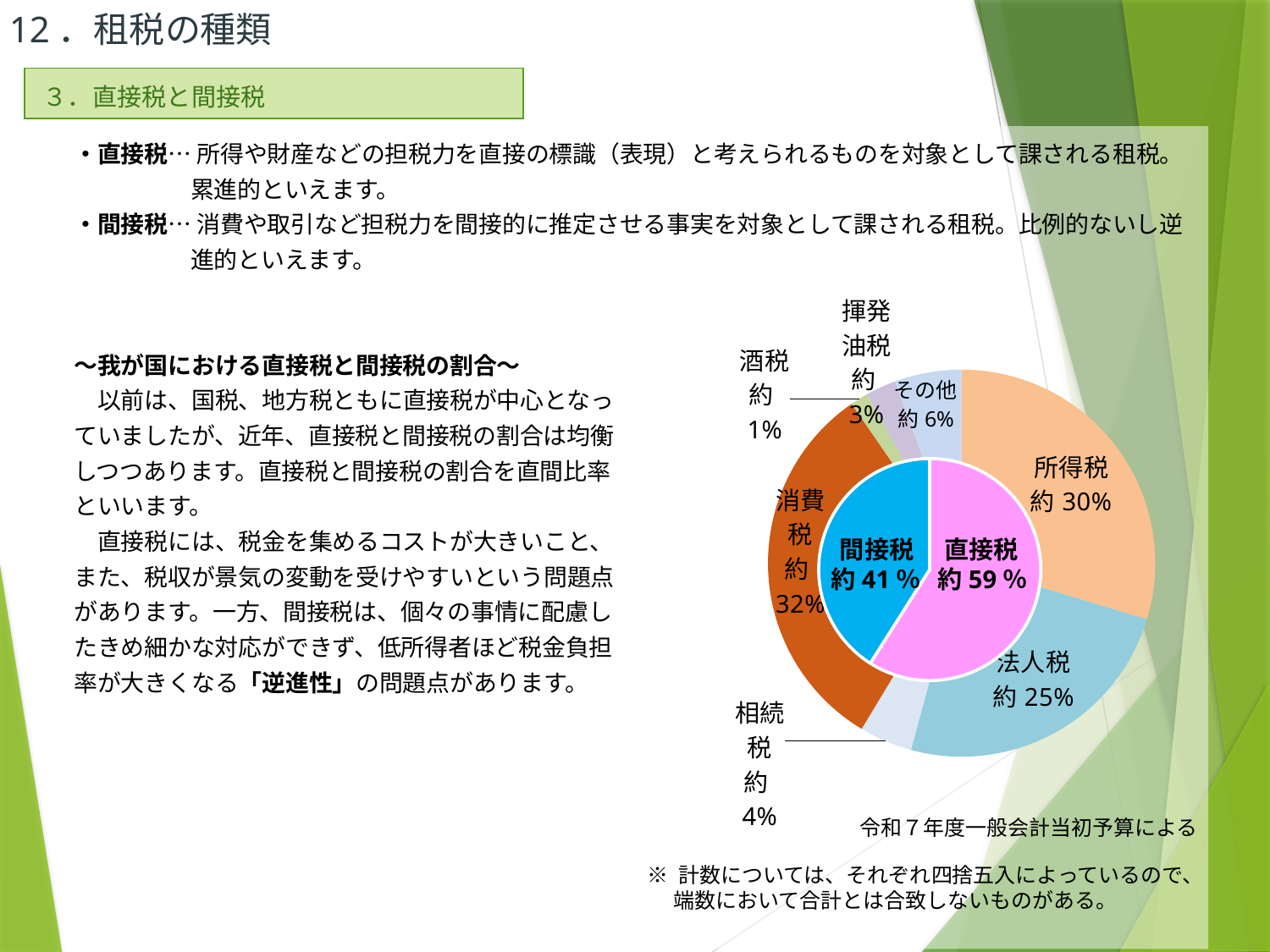
円グラフで、所得税の割合はいくらですか？ 約 30% 円グラフで、所得税と法人税ではどちらの割合が大きいですか？ 所得税 円グラフで、法人税の割合はいくらですか？ 約 25% 円グラフで、相続税の割合はいくらですか？ 約 4% 円グラフの外側の輪で、最も割合が小さい税目はどれですか？ 酒税 円グラフで、消費税の割合はいくらですか？ 約 32% 円グラフで、直接税と間接税の割合の差は何ポイントですか？ 18ポイント このスライドのグラフはどの種類のグラフですか？ 円グラフ 円グラフの外側の輪には、いくつの税目が示されていますか？ 7 円グラフの内側の輪で、直接税の割合はいくらですか？ 約 59 % 円グラフの内側の輪で、間接税の割合はいくらですか？ 約 41 % 円グラフの外側の輪で、最も割合が大きい税目はどれですか？ 消費税